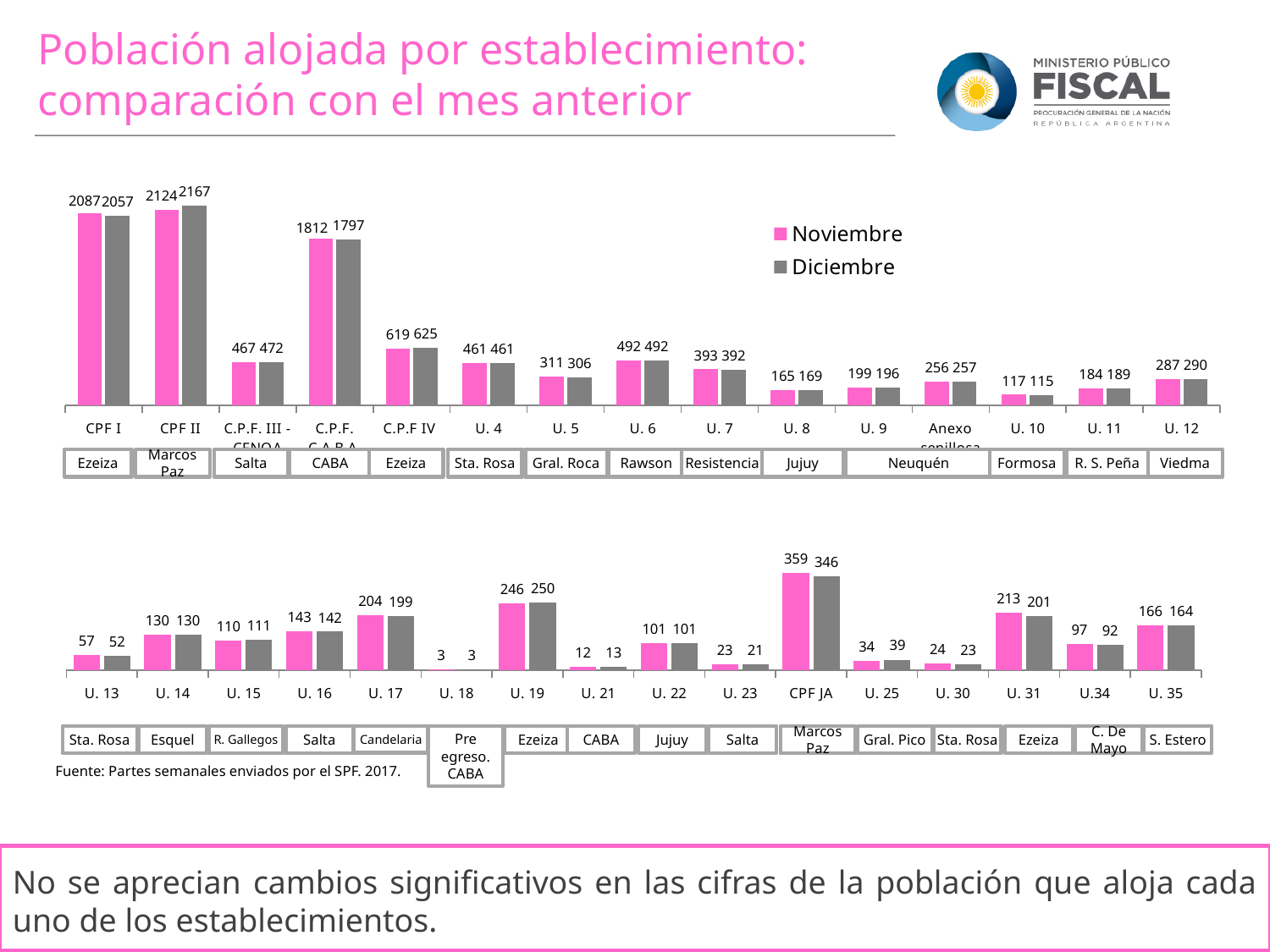
In the top chart, what is the difference between the Noviembre and Diciembre values for CPF I? 30 In the top chart, what is the Diciembre value for C.P.F IV? 625 In the top chart, which category has the highest Diciembre value? CPF II In the bottom chart, which category has the lowest Noviembre value? U. 18 In the bottom chart, what is the Diciembre value for CPF JA? 346 In the top chart, what is the Noviembre value for CPF I? 2087 In the top chart, which category has the lowest Noviembre value? U. 10 In the bottom chart, what is the difference between the Noviembre and Diciembre values for U. 31? 12 How many categories are shown in the bottom chart? 16 What type of chart is the top chart? Bar chart How many series does the legend of the top chart list? 2 In the bottom chart, which is larger: the Noviembre value for U. 17 or the Noviembre value for U. 19? U. 19